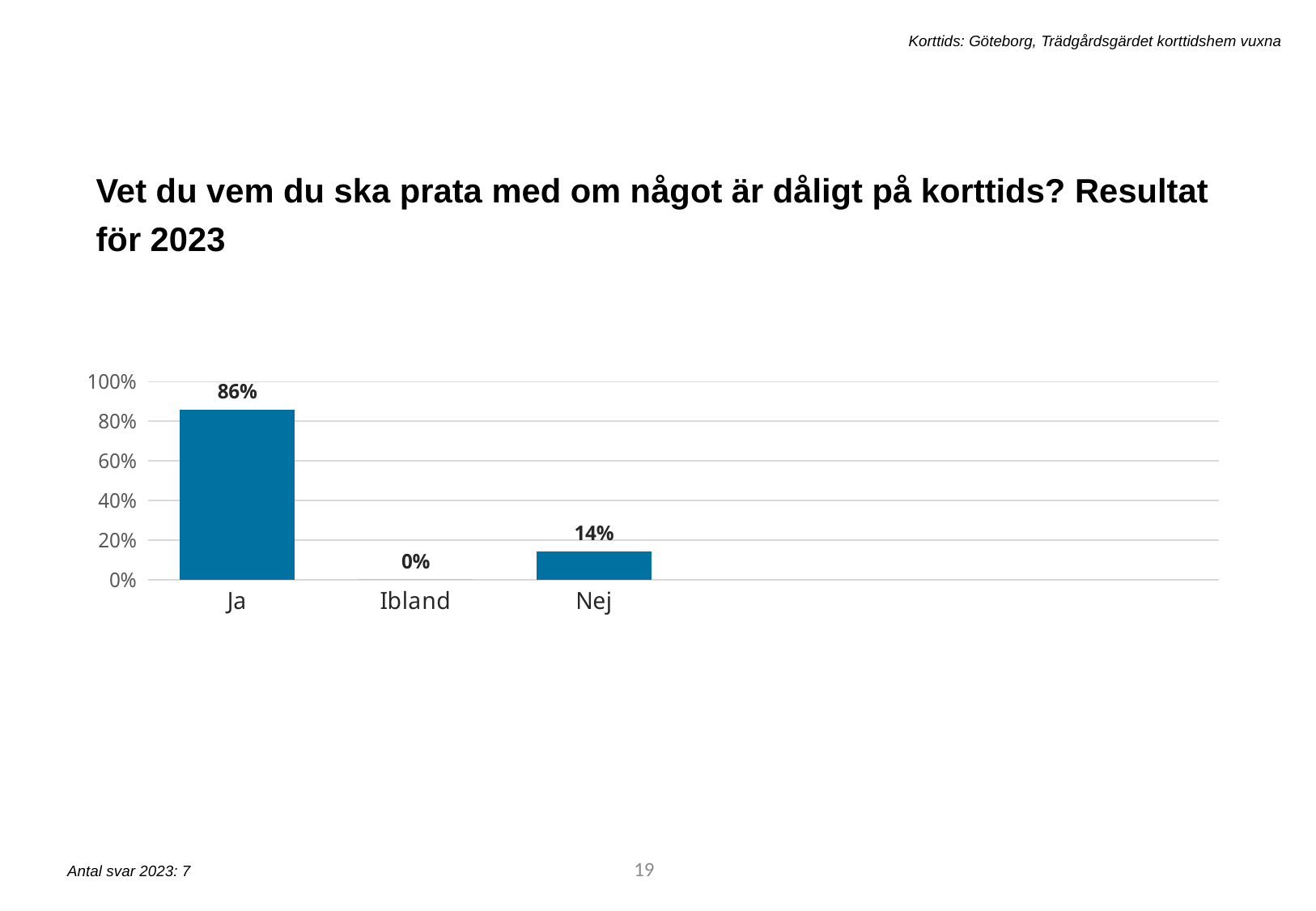
Is the value for Nej greater or less than 20%? less What kind of chart is shown on the slide? bar chart Is the value for Ja greater or less than 80%? greater What is the value for Nej? 14% Which category has the lowest value? Ibland What is the value for Ja? 86% Which is larger, the value for Nej or the value for Ibland? Nej What is the value for Ibland? 0% What is the highest value shown on the y axis? 100% What is the difference between the values for Ja and Nej? 72% How many categories are shown on the x axis? 3 Which category has the highest value? Ja